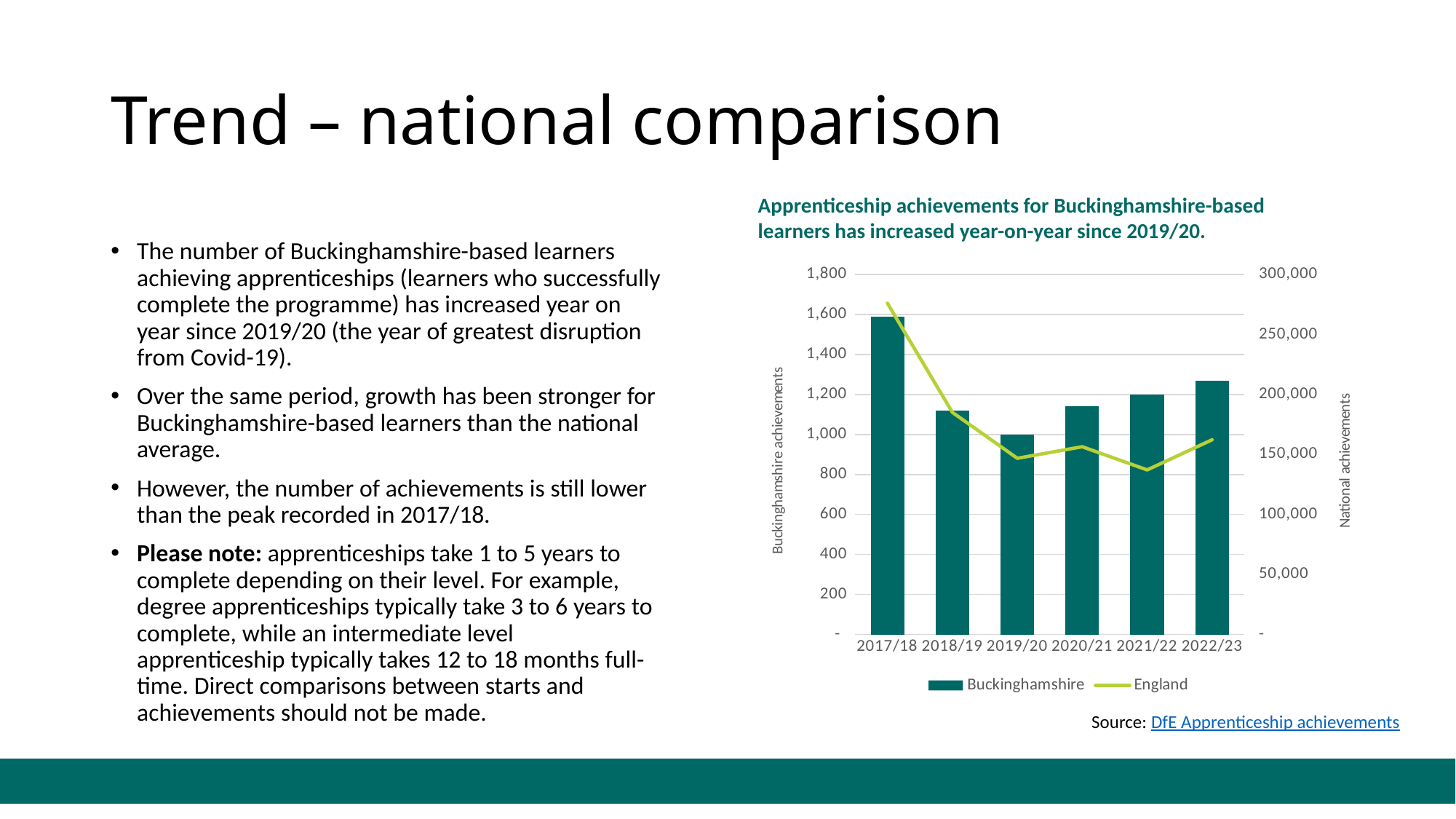
Is the England value for 2021/22 greater or less than 150,000? less In which year is the Buckinghamshire bar highest? 2017/18 Is the Buckinghamshire value for 2022/23 greater or less than 1,400? less Do the Buckinghamshire bars rise or fall from 2019/20 to 2022/23? rise How many academic years are shown on the x axis of the chart? 6 Which is larger, the Buckinghamshire value for 2022/23 or for 2018/19? 2022/23 What type of chart is shown on the slide? A combined bar and line chart Is the Buckinghamshire value for 2017/18 greater or less than 1,400? greater In which year is the Buckinghamshire bar lowest? 2019/20 Which series is plotted as bars in the chart? Buckinghamshire How many series does the chart legend list? 2